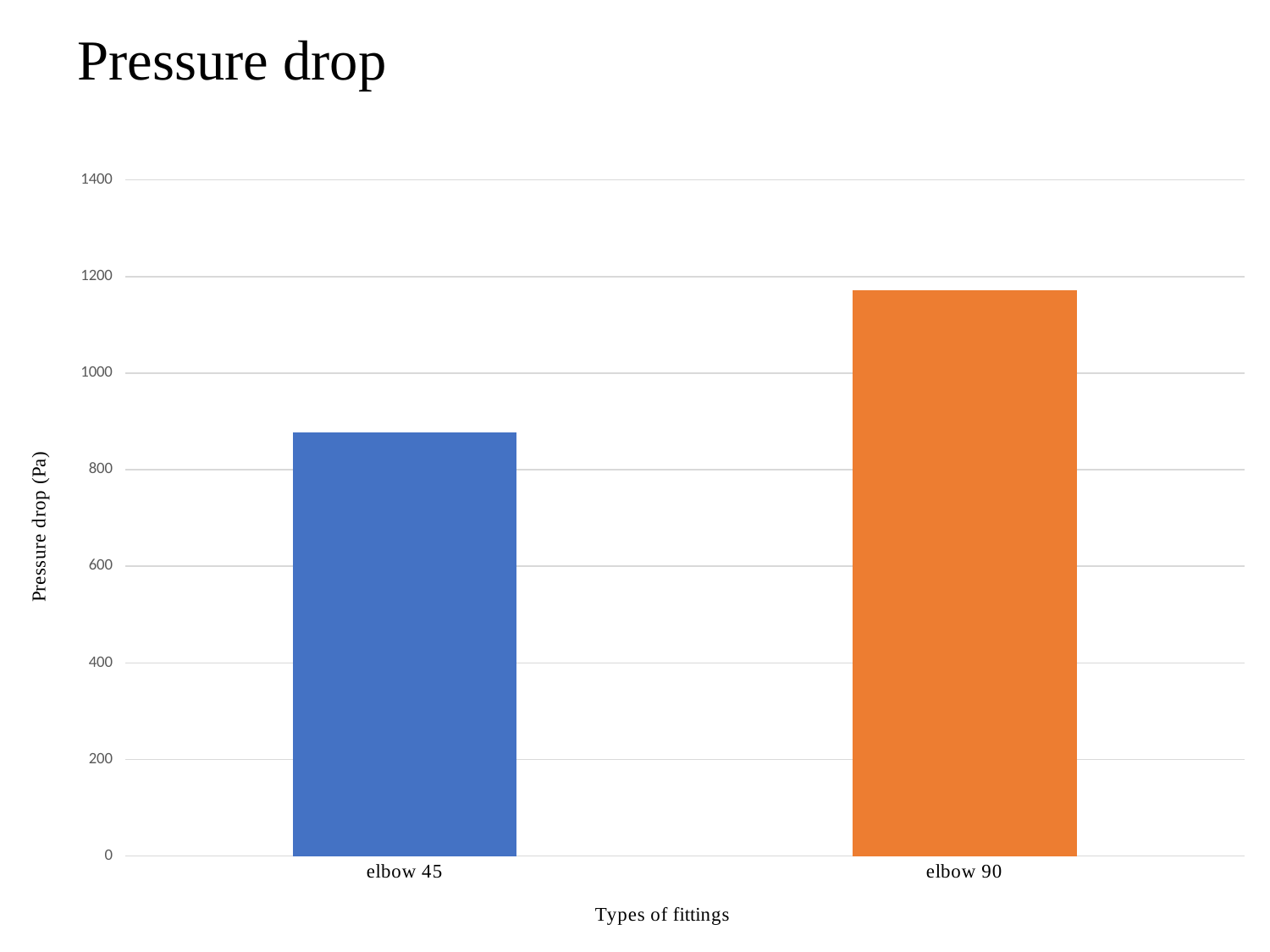
Which has a larger pressure drop, elbow 45 or elbow 90? elbow 90 Which type of fitting has the highest pressure drop? elbow 90 Is the pressure drop for elbow 90 greater or less than 1200? less What is the label of the vertical axis? Pressure drop (Pa) Is the pressure drop for elbow 45 greater or less than 1000? less Which type of fitting has the lowest pressure drop? elbow 45 Is the pressure drop for elbow 90 greater or less than 1000? greater What is the label of the horizontal axis? Types of fittings How many types of fittings are plotted on the chart? 2 What kind of chart is shown on the slide? bar chart